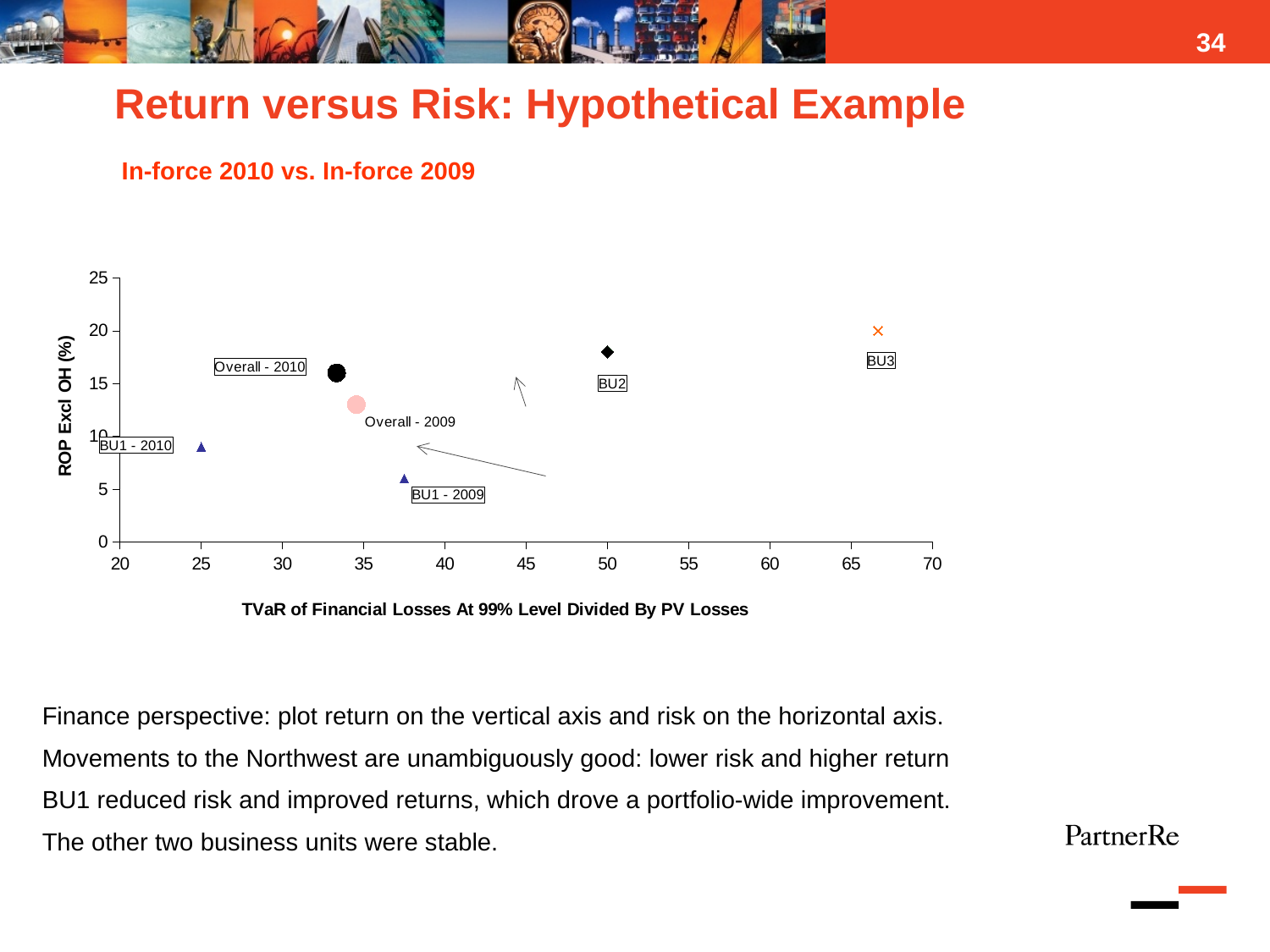
Which labelled point has the highest ROP Excl OH (%)? BU3 Is the horizontal-axis (TVaR) value for BU3 greater or less than 60? greater Is the ROP Excl OH (%) value for BU2 greater or less than 15? greater How many data points are plotted on the chart? 6 Which labelled point has the highest value on the horizontal (TVaR) axis? BU3 Which labelled point has the lowest ROP Excl OH (%)? BU1 - 2009 Is the ROP Excl OH (%) value for BU1 - 2009 greater or less than 10? less What kind of chart is shown on the slide? Scatter chart Which labelled point has the lowest value on the horizontal (TVaR) axis? BU1 - 2010 Which has the larger horizontal-axis (TVaR) value: BU1 - 2010 or BU1 - 2009? BU1 - 2009 What is the title of the horizontal axis of the chart? TVaR of Financial Losses At 99% Level Divided By PV Losses Which has the higher ROP Excl OH (%): Overall - 2010 or Overall - 2009? Overall - 2010